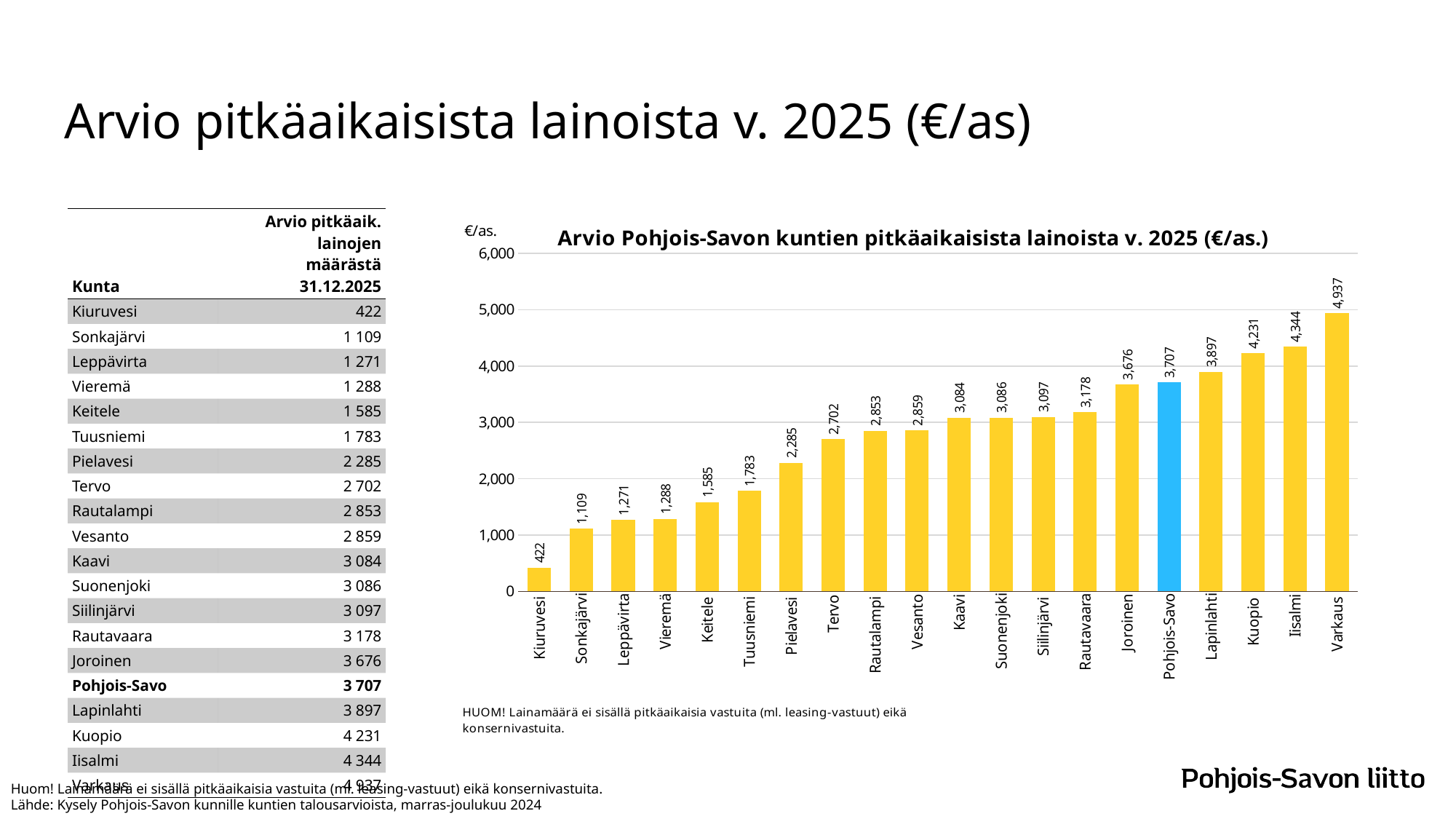
What is the value for Tervo in the chart? 2,702 Which bar in the chart is coloured blue instead of yellow? Pohjois-Savo Which municipality has the highest value in the chart? Varkaus Is the value for Pielavesi greater or less than 2,000? greater What is the value for Pohjois-Savo in the chart? 3,707 What is the value for Kuopio in the chart? 4,231 How many municipalities/categories are shown on the x axis of the chart? 20 What is the difference between the values for Varkaus and Kiuruvesi? 4,515 Which municipality has the lowest value in the chart? Kiuruvesi Which has a larger value, Lapinlahti or Joroinen? Lapinlahti What kind of chart is shown on the slide? bar chart What is the difference between the values for Iisalmi and Kuopio? 113